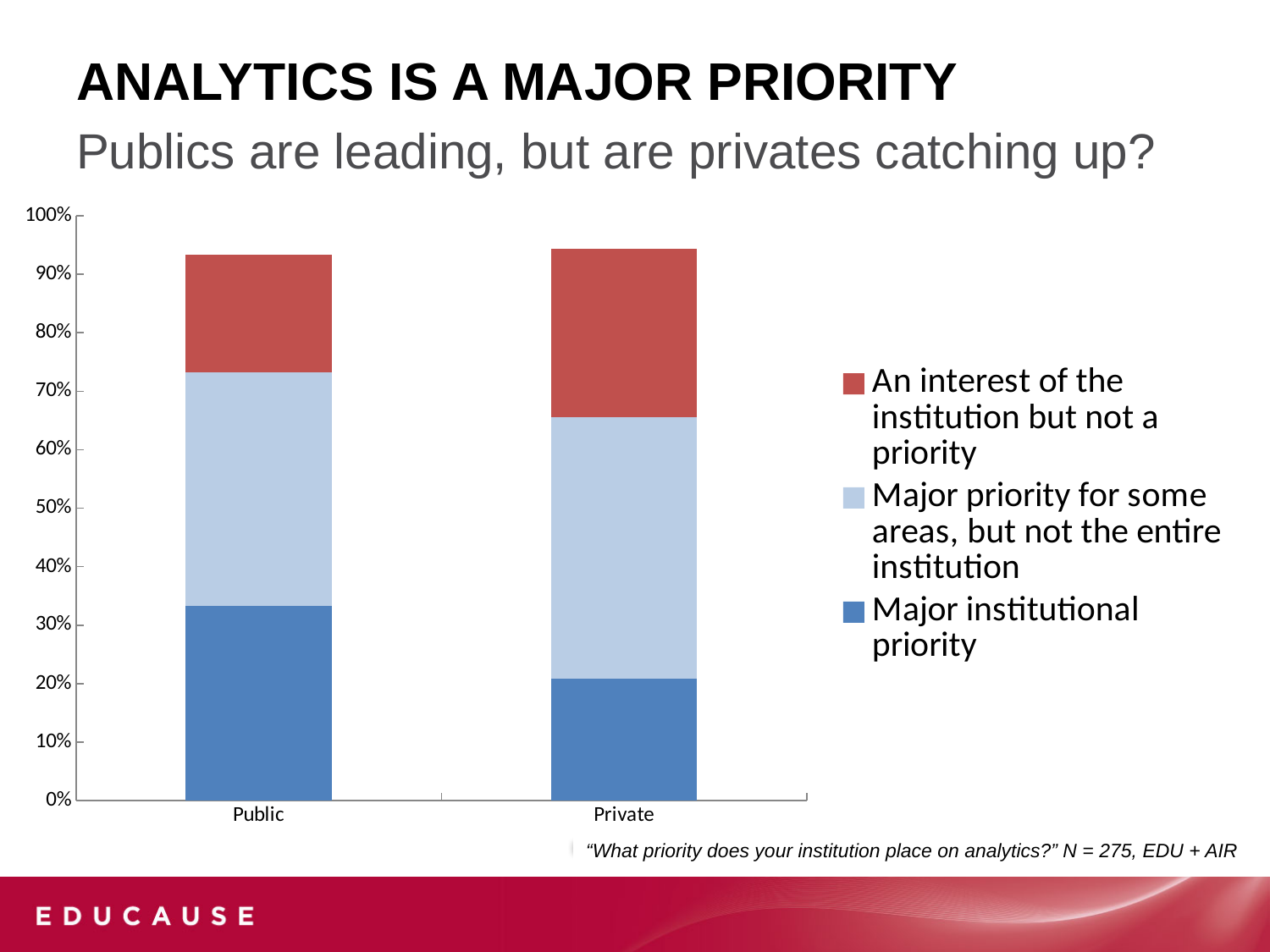
How many categories are shown on the x axis of the chart? 2 Is the 'Major institutional priority' value for Public greater or less than 30%? greater Is the 'Major institutional priority' value for Private greater or less than 10%? greater Is the top of the stacked bar for Public greater or less than 90%? greater Which two categories are shown on the x axis? Public and Private What kind of chart is shown on the slide? Stacked bar chart Which category has the larger 'Major institutional priority' segment, Public or Private? Public Which category has the larger 'An interest of the institution but not a priority' segment, Public or Private? Private Which series is shown in red in the chart? An interest of the institution but not a priority How many series does the chart's legend list? 3